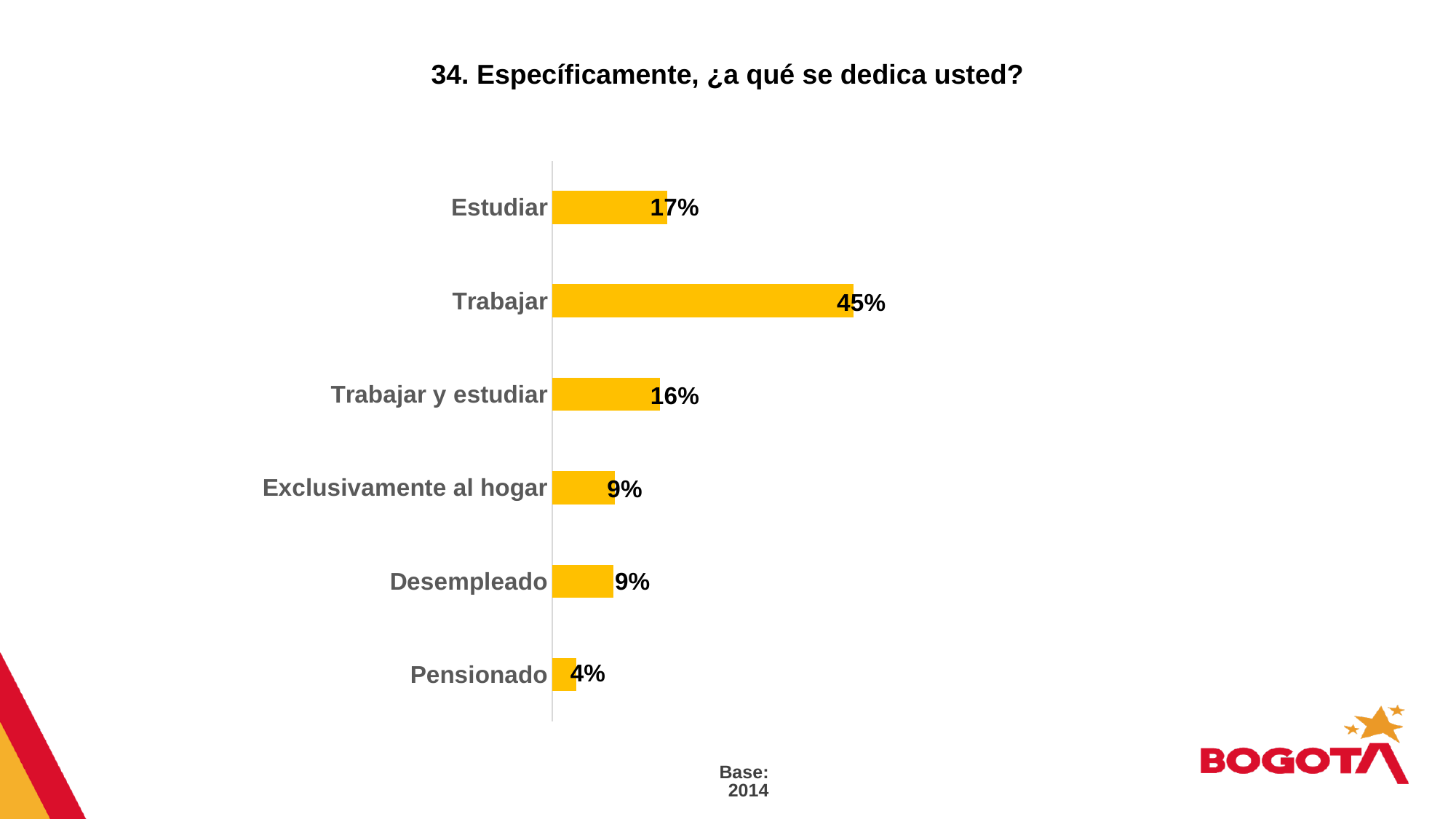
Which category has the highest value? Trabajar What is the difference between the values for Trabajar and Estudiar? 28% How many categories are shown in the chart? 6 Which category has the lowest value? Pensionado What is the value for Estudiar? 17% What kind of chart is shown on the slide? Bar chart What is the value for Trabajar y estudiar? 16% Which is larger, the value for Estudiar or the value for Desempleado? Estudiar What is the value for Pensionado? 4% What is the value for Trabajar? 45% What is the difference between the values for Exclusivamente al hogar and Pensionado? 5% What is the title of the chart? 34. Específicamente, ¿a qué se dedica usted?